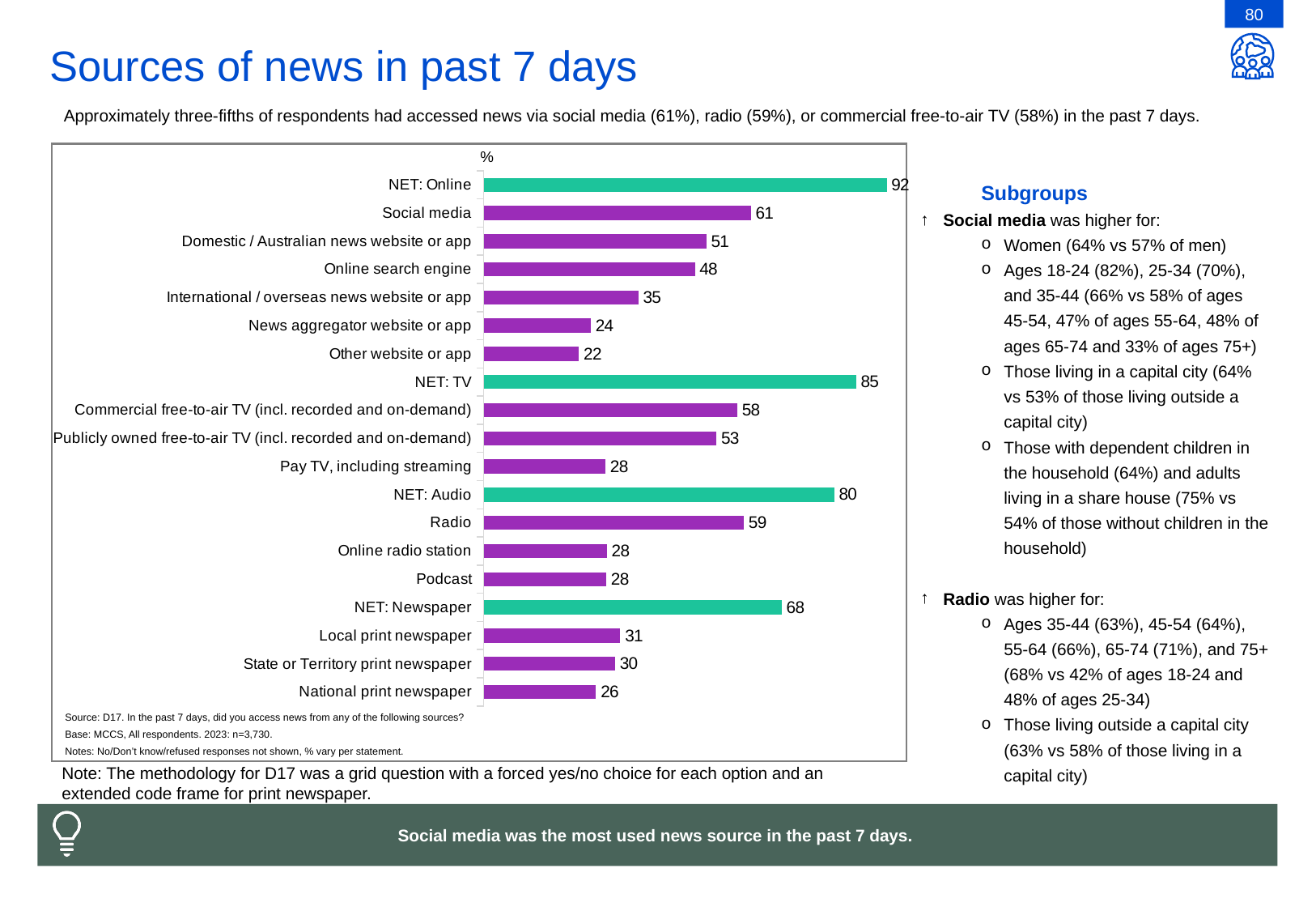
What kind of chart is shown on the slide? Bar chart What is the value for Social media? 61 Which category has the highest value? NET: Online What is the difference between the values for Radio and Podcast? 31 How many categories are shown in the chart? 19 Which is larger, the value for Online search engine or the value for International / overseas news website or app? Online search engine What is the value for National print newspaper? 26 What is the value for Publicly owned free-to-air TV (incl. recorded and on-demand)? 53 What is the difference between the values for NET: Online and NET: TV? 7 Which category has the lowest value? Other website or app What is the value for NET: Audio? 80 Which is larger, the value for Local print newspaper or the value for News aggregator website or app? Local print newspaper